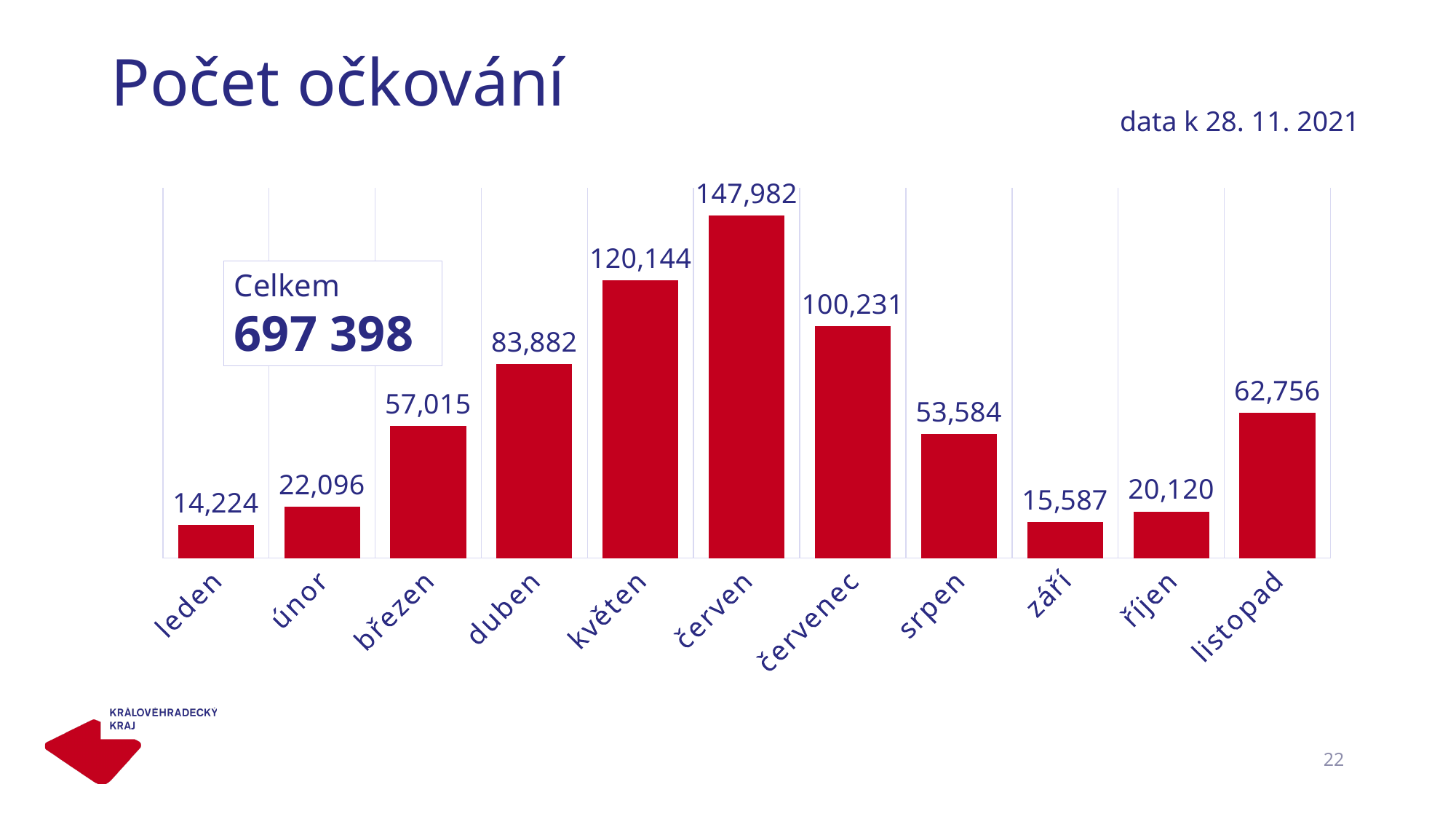
What total (Celkem) is shown in the box on the chart? 697 398 What is the difference between the values for červen and květen? 27,838 What is the difference between the values for listopad and říjen? 42,636 How many months are shown on the x axis? 11 Do the values rise or fall from leden to červen? rise What is the value for listopad? 62,756 Which month has the highest value? červen What is the value for květen? 120,144 Which is larger, the value for duben or the value for srpen? duben Which month has the lowest value? leden What kind of chart is shown on the slide? bar chart What is the value for září? 15,587